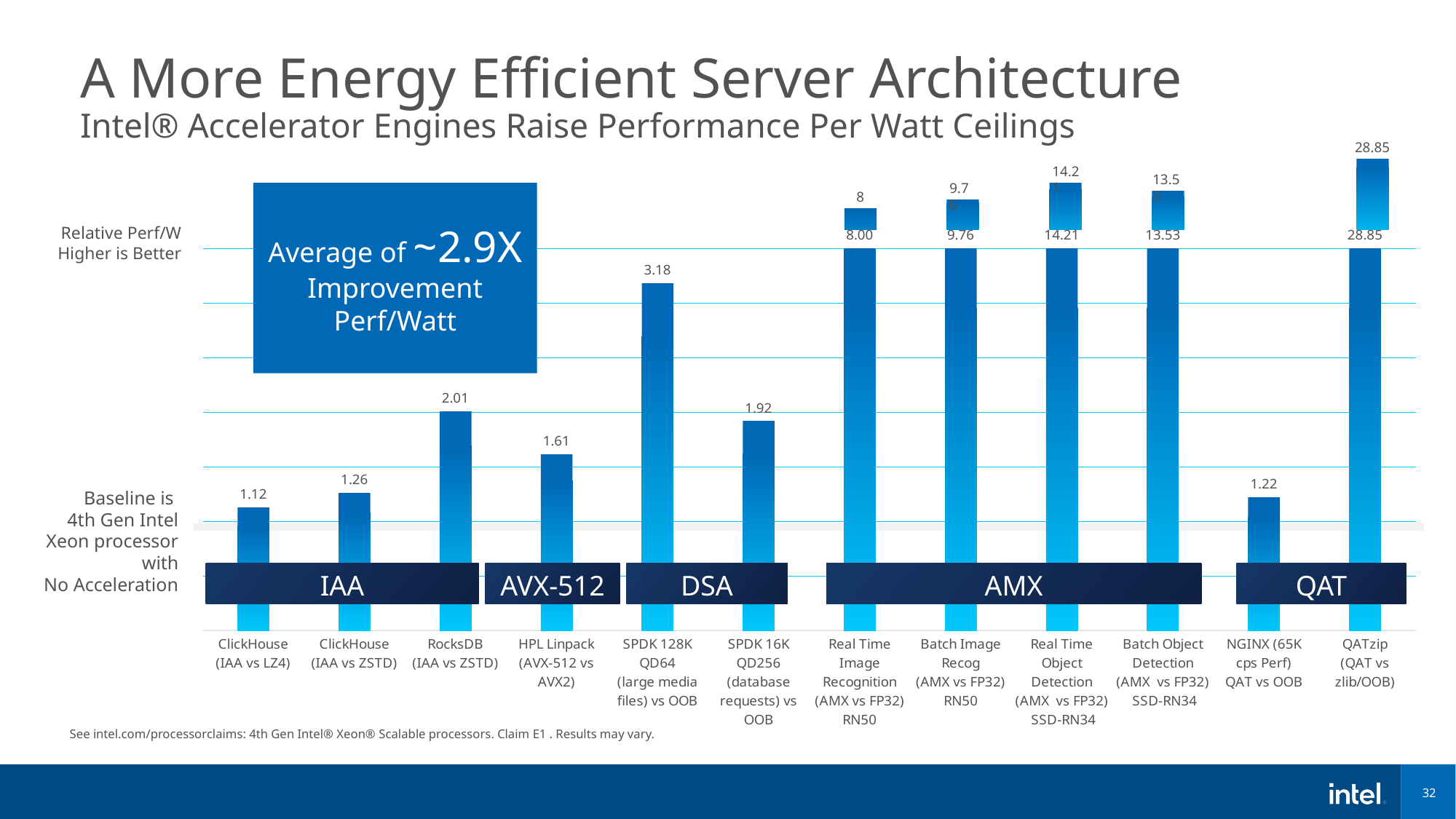
What is the relative Perf/W value for ClickHouse (IAA vs LZ4)? 1.12 How many workloads are plotted in the chart? 12 What is the difference between the relative Perf/W values for RocksDB (IAA vs ZSTD) and ClickHouse (IAA vs ZSTD)? 0.75 What is the relative Perf/W value for SPDK 128K QD64 (large media files) vs OOB? 3.18 What is the relative Perf/W value for NGINX (65K cps Perf) QAT vs OOB? 1.22 According to the callout box on the chart, what is the average Perf/Watt improvement? ~2.9X What is the relative Perf/W value for Real Time Object Detection (AMX vs FP32) SSD-RN34? 14.21 Which workload has the lowest relative Perf/W value? ClickHouse (IAA vs LZ4) Which workload has the highest relative Perf/W value? QATzip (QAT vs zlib/OOB) Which has a higher relative Perf/W value: Batch Image Recog (AMX vs FP32) RN50 or Real Time Image Recognition (AMX vs FP32) RN50? Batch Image Recog (AMX vs FP32) RN50 What kind of chart is shown on the slide? Bar chart How many workloads are grouped under the AMX accelerator label? 4